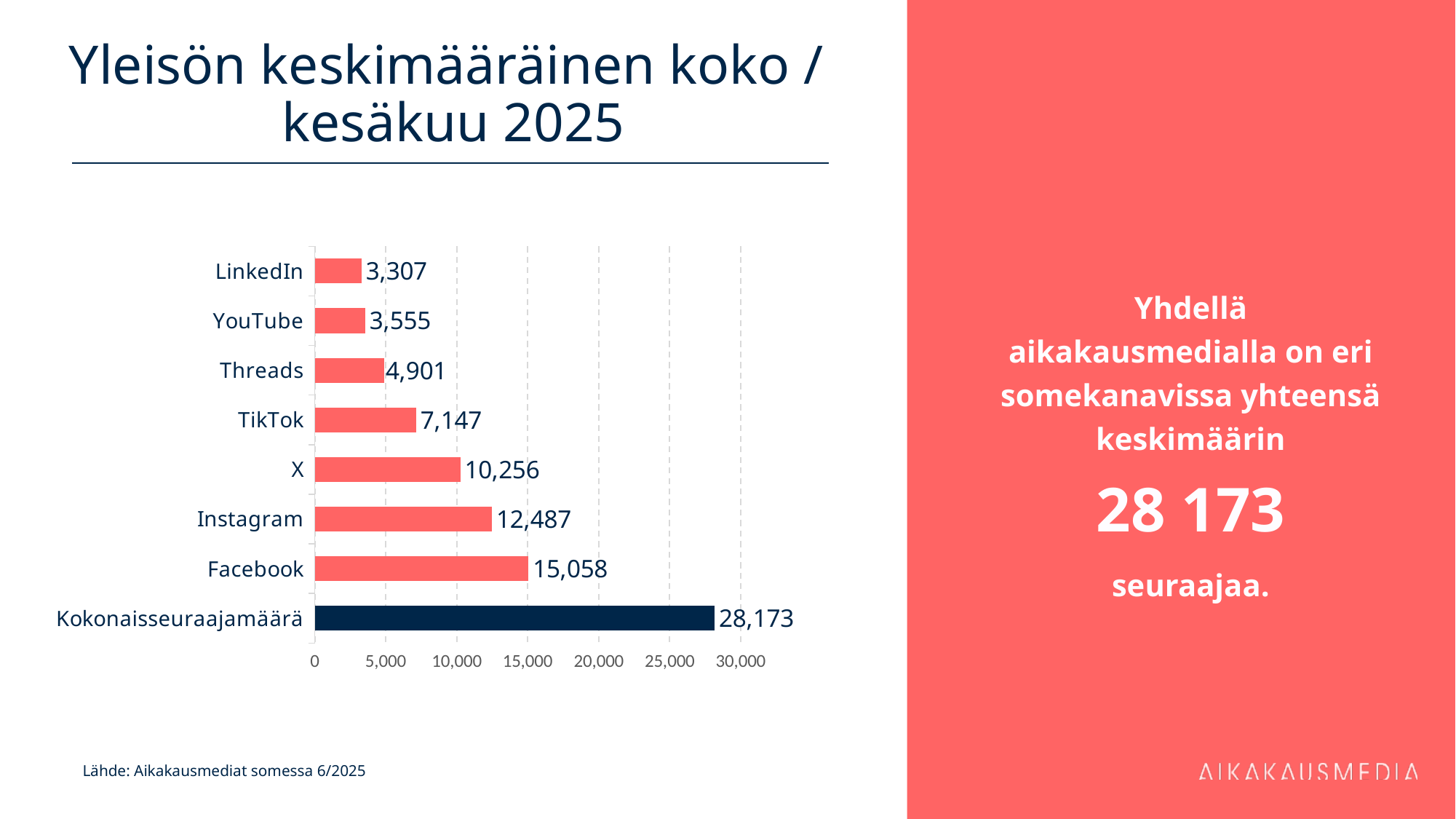
Is the value for Instagram greater or less than 10,000? greater What is the value for TikTok? 7,147 What is the difference between the values for Facebook and Instagram? 2,571 Which category has the highest value? Kokonaisseuraajamäärä What kind of chart is shown on the slide? Bar chart Which bar is coloured dark navy instead of red? Kokonaisseuraajamäärä Which category has the lowest value? LinkedIn What is the value for Facebook? 15,058 What is the value for Kokonaisseuraajamäärä? 28,173 How many categories are shown in the chart? 8 Which is larger, the value for X or the value for Threads? X What is the title of the slide? Yleisön keskimääräinen koko / kesäkuu 2025